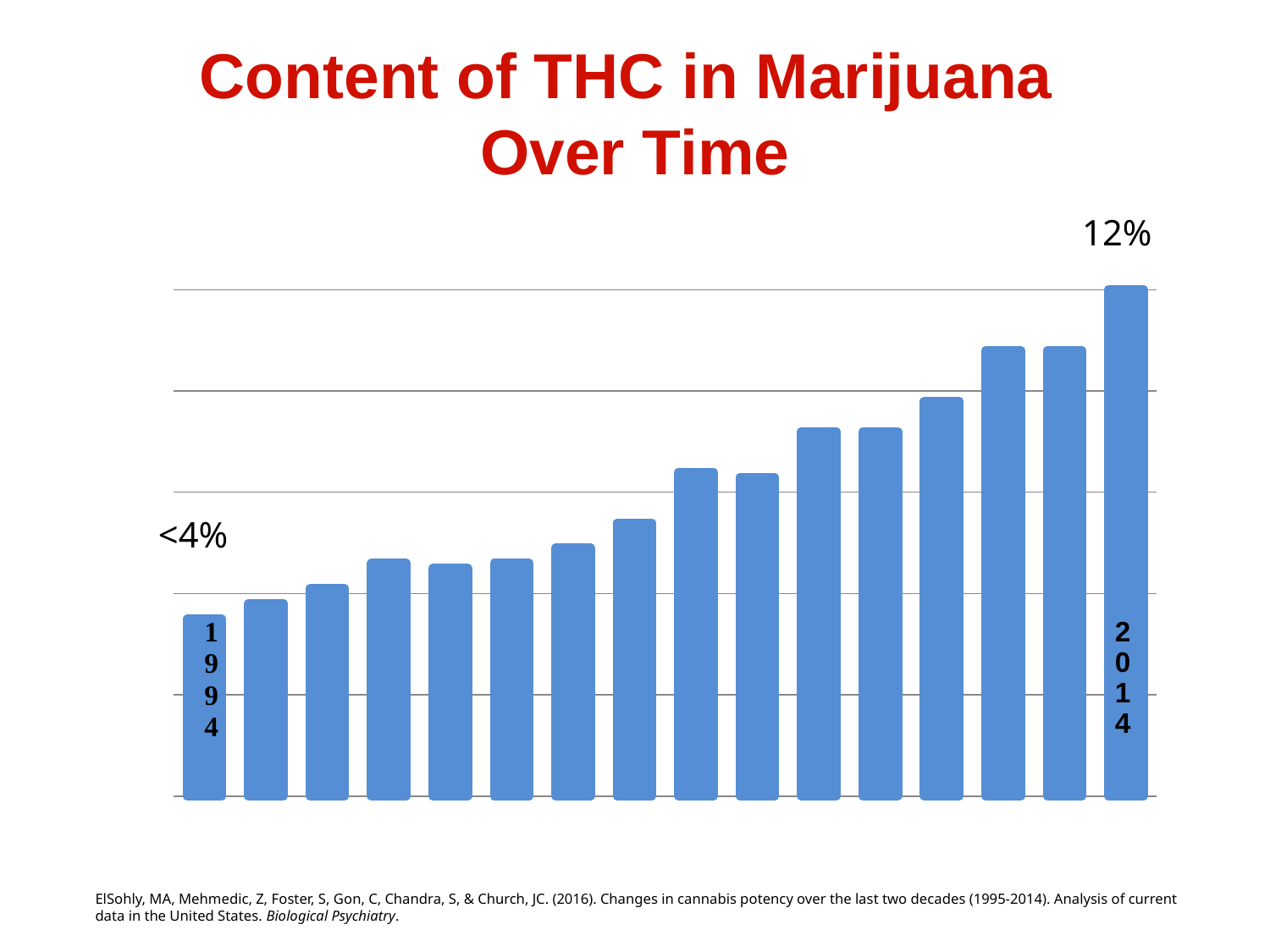
What is the title of the chart? Content of THC in Marijuana Over Time What is the first year labelled on the x axis? 1994 Which year has the lowest THC content in the chart? 1994 What is the last year labelled on the x axis? 2014 Do the values generally rise or fall from 1994 to 2014? rise Which year has the larger THC content, 1994 or 2014? 2014 How many bars are plotted in the chart? 16 Which year has the highest THC content in the chart? 2014 What THC content is labelled for 2014? 12% What label is shown next to the 1994 bar indicating its THC content? <4% What kind of chart is shown on the slide? bar chart